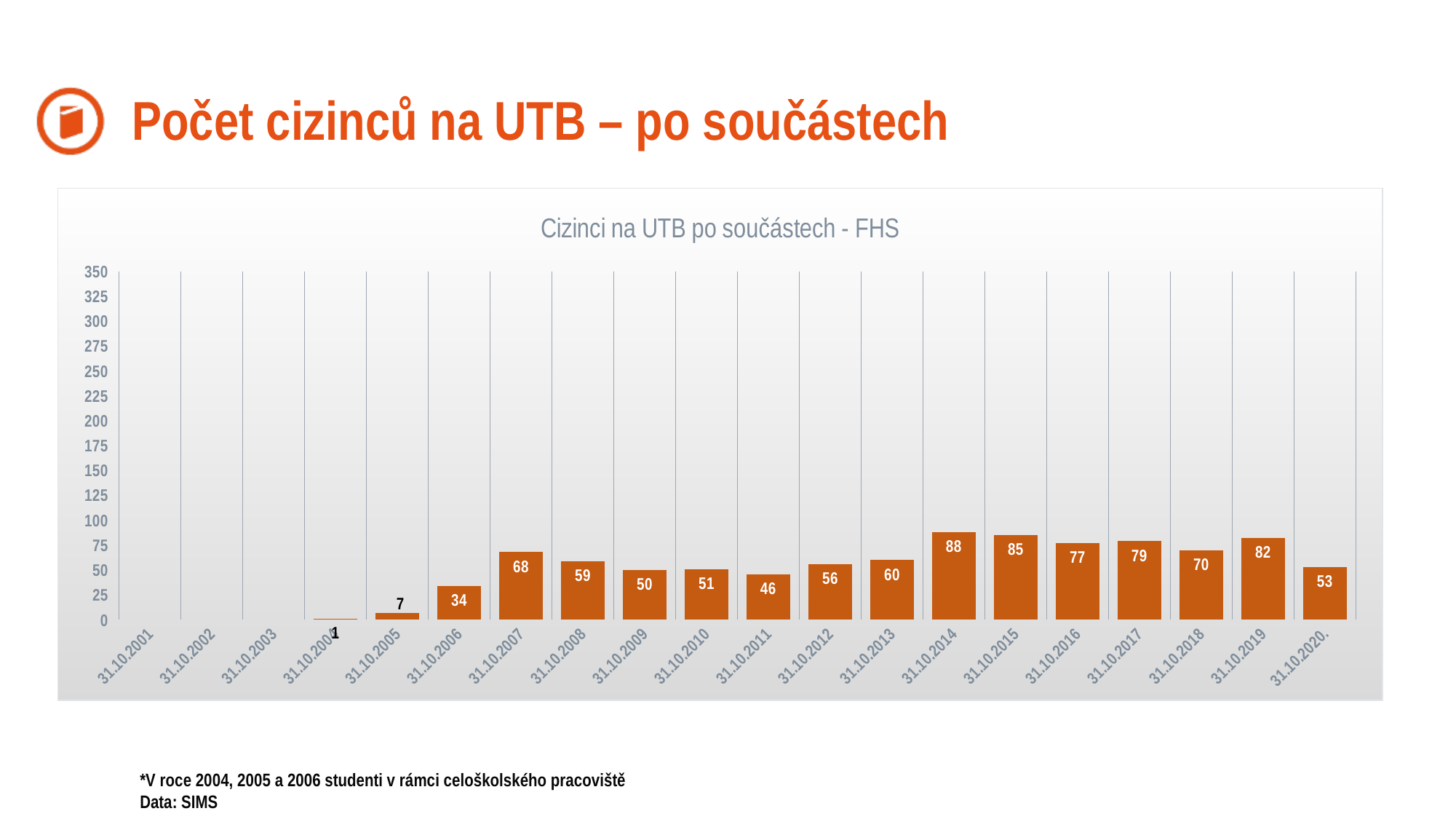
What is the value for 31.10.2007? 68 Which date has the highest value in the chart? 31.10.2014 What is the value for 31.10.2020? 53 What is the value for 31.10.2005? 7 Which is larger, the value for 31.10.2016 or the value for 31.10.2017? 31.10.2017 What is the difference between the values for 31.10.2014 and 31.10.2015? 3 What kind of chart is shown on the slide? bar chart What is the title of the chart? Cizinci na UTB po součástech - FHS Is the value for 31.10.2013 greater or less than 100? less What is the value for 31.10.2014 in the chart? 88 How many dates are shown on the x axis of the chart? 20 What is the difference between the values for 31.10.2019 and 31.10.2018? 12